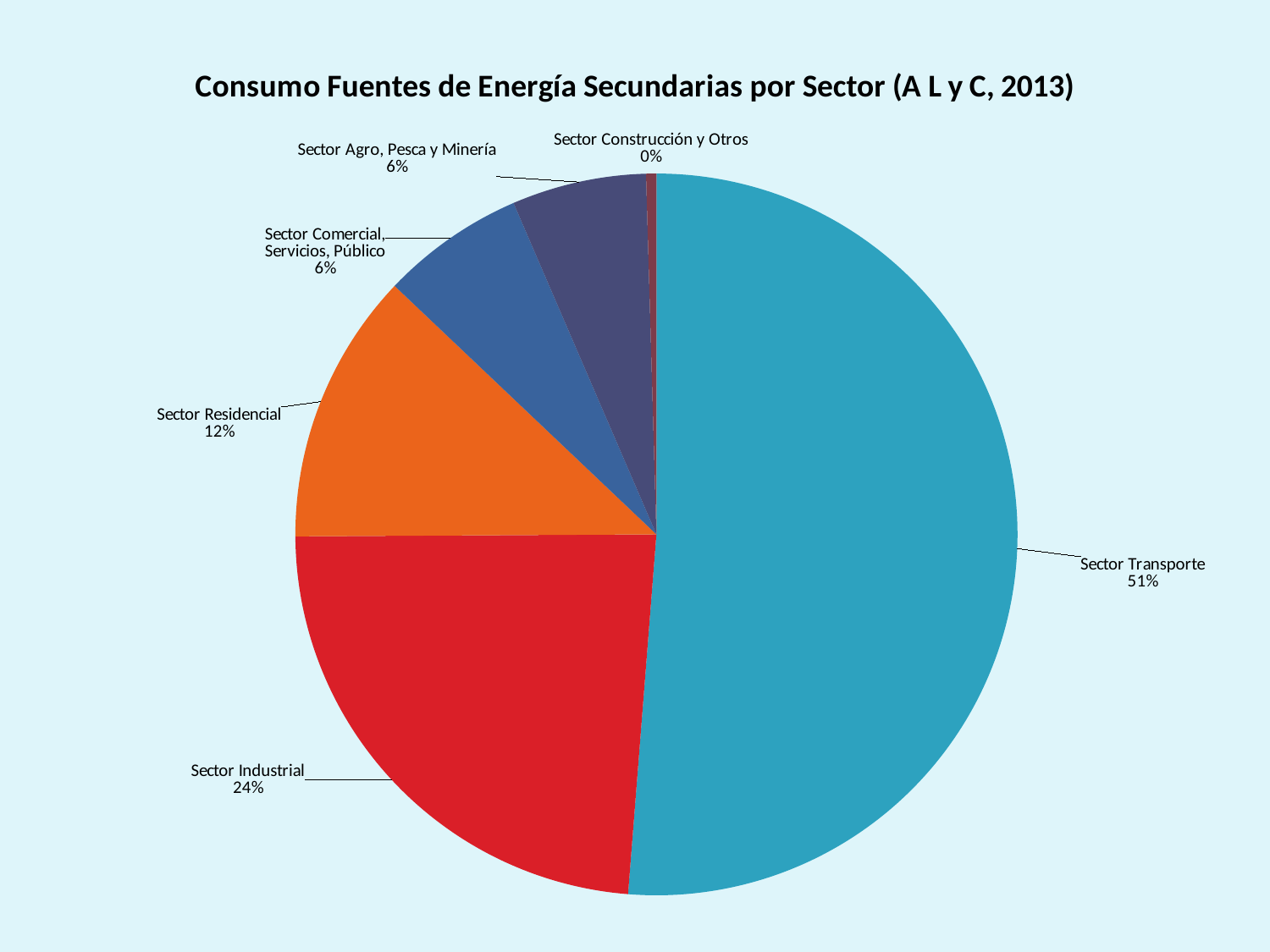
What is the value shown for Sector Construcción y Otros? 0% Which sector has the smallest share of the pie? Sector Construcción y Otros Which is larger, Sector Residencial or Sector Comercial, Servicios, Público? Sector Residencial What type of chart is shown on the slide? pie chart What is the value shown for Sector Agro, Pesca y Minería? 6% What share of the pie does Sector Transporte represent? 51% What is the value shown for Sector Residencial? 12% How many sectors are shown in the pie chart? 6 Which sector has the largest share of the pie? Sector Transporte What is the difference in percentage points between Sector Transporte and Sector Industrial? 27 What is the title of the chart? Consumo Fuentes de Energía Secundarias por Sector (A L y C, 2013) What share of the pie does Sector Industrial represent? 24%